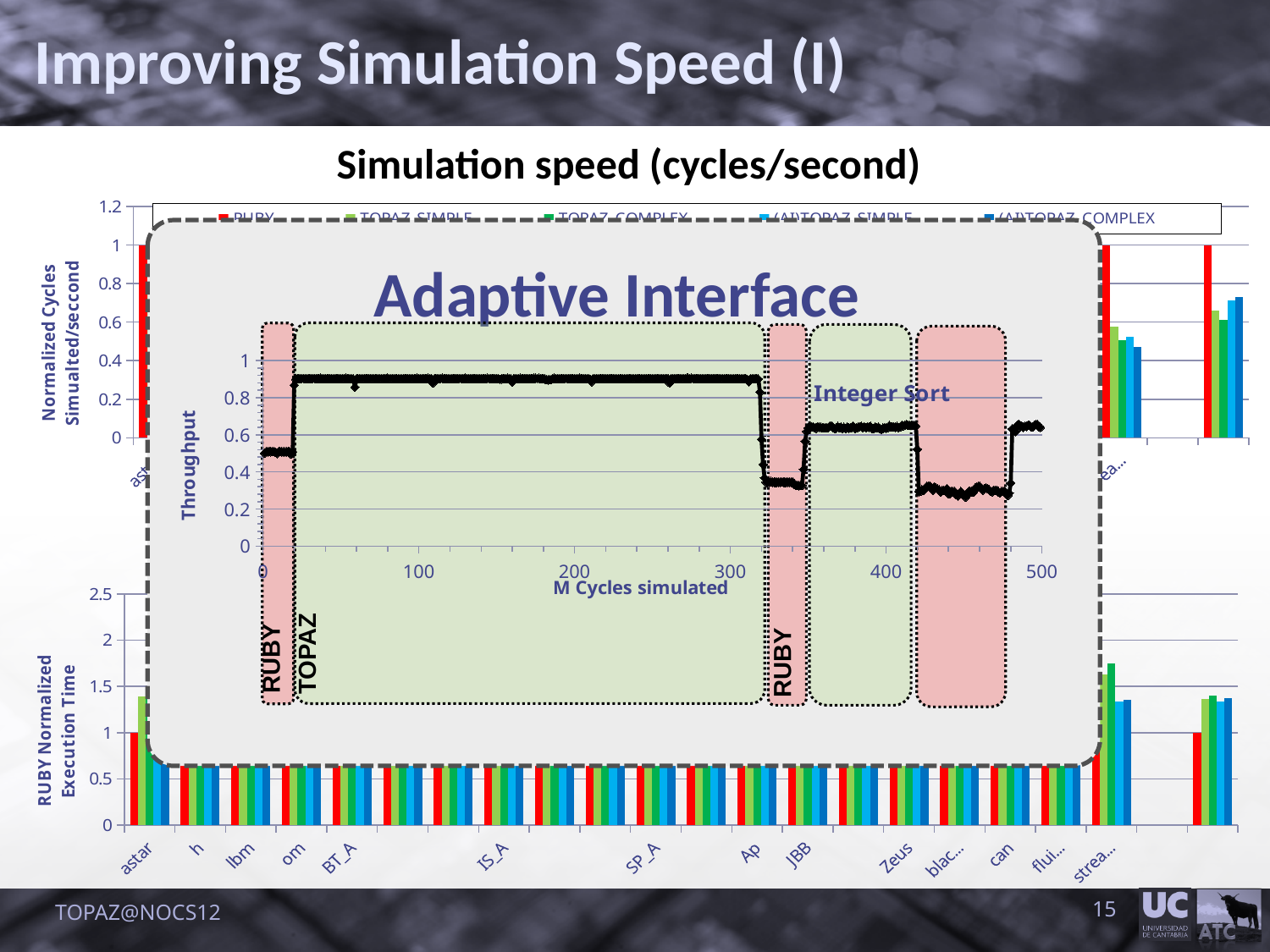
In the bottom 'RUBY Normalized Execution Time' chart, which is larger for astar: the RUBY bar or the TOPAZ SIMPLE bar? TOPAZ SIMPLE What is the y-axis label of the 'Adaptive Interface' line chart? Throughput In the 'Adaptive Interface' line chart, is the throughput at 400 M cycles simulated greater or less than 0.4? greater How many series does the legend of the top 'Simulation speed (cycles/second)' chart list? 5 What kind of chart is the overlaid 'Adaptive Interface' chart in the centre of the slide? line chart In the 'Adaptive Interface' line chart, is the throughput at 450 M cycles simulated greater or less than 0.4? less In the 'Adaptive Interface' line chart, is the throughput higher at 200 M cycles simulated or at 450 M cycles simulated? 200 M cycles simulated In the 'Adaptive Interface' line chart, is the throughput at 200 M cycles simulated greater or less than 0.8? greater What kind of chart is the bottom chart with the y-axis 'RUBY Normalized Execution Time'? bar chart In the bottom 'RUBY Normalized Execution Time' chart, what is the value of the RUBY bar for astar? 1 What is the x-axis label of the 'Adaptive Interface' line chart? M Cycles simulated